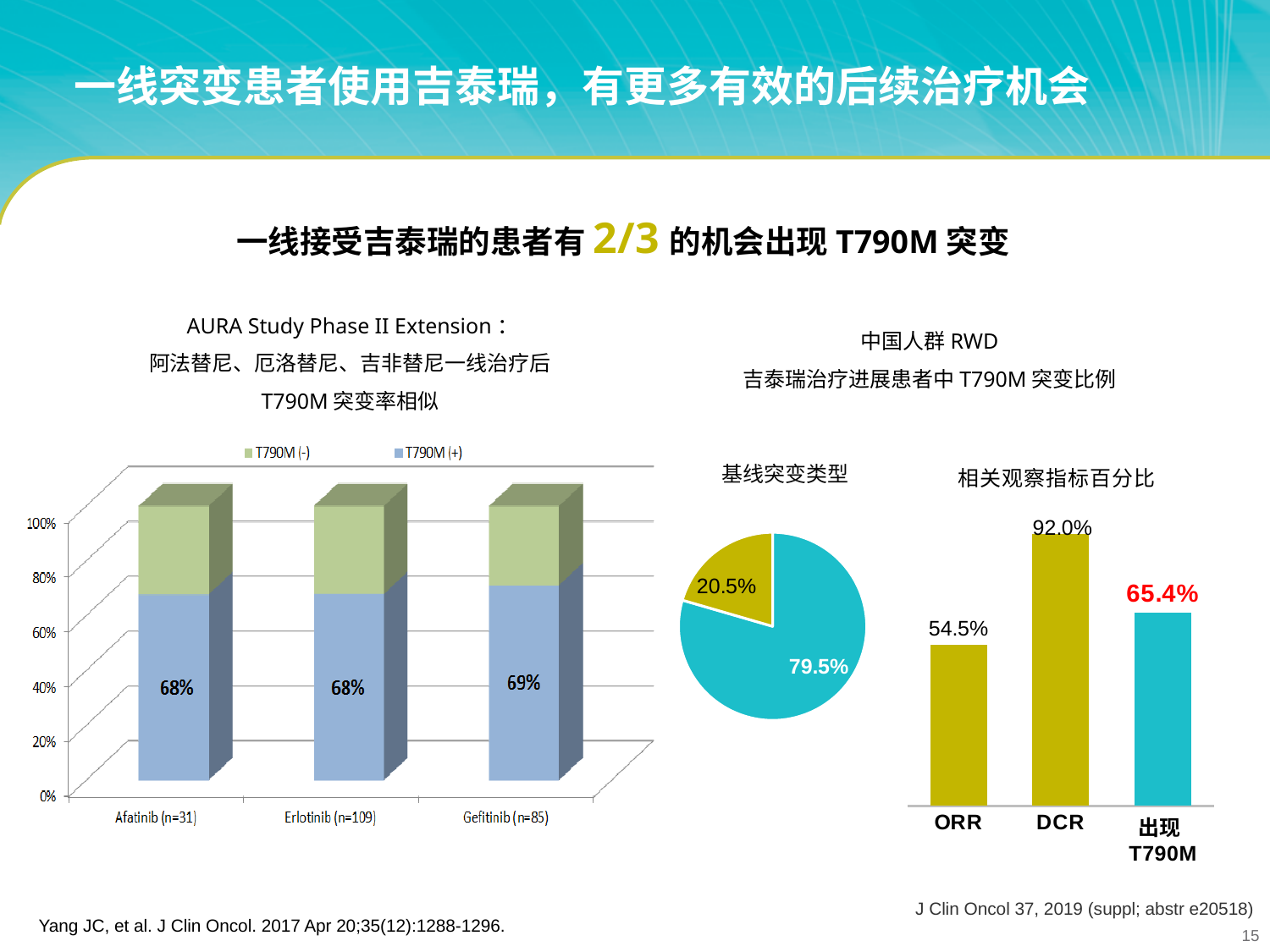
In the left chart (AURA Study Phase II Extension), what is the T790M (+) value for Gefitinib (n=85)? 69% In the left chart (AURA Study Phase II Extension), what is the T790M (+) value for Erlotinib (n=109)? 68% In the left chart (AURA Study Phase II Extension), how many categories are shown on the x axis? 3 In the left chart (AURA Study Phase II Extension), how many series does the legend list? 2 In the pie chart titled 基线突变类型, how many slices are there? 2 In the right chart titled 相关观察指标百分比, what colour is the 出现T790M bar? Cyan (blue) In the right chart titled 相关观察指标百分比, which category has the lowest value? ORR In the right chart titled 相关观察指标百分比, which is larger, ORR or 出现T790M? 出现T790M What kind of chart is the left chart (AURA Study Phase II Extension)? Stacked bar chart In the pie chart titled 基线突变类型, what is the value of the smaller slice? 20.5% In the right chart titled 相关观察指标百分比, what is the difference between DCR and ORR? 37.5% In the right chart titled 相关观察指标百分比, what is the value for DCR? 92.0%